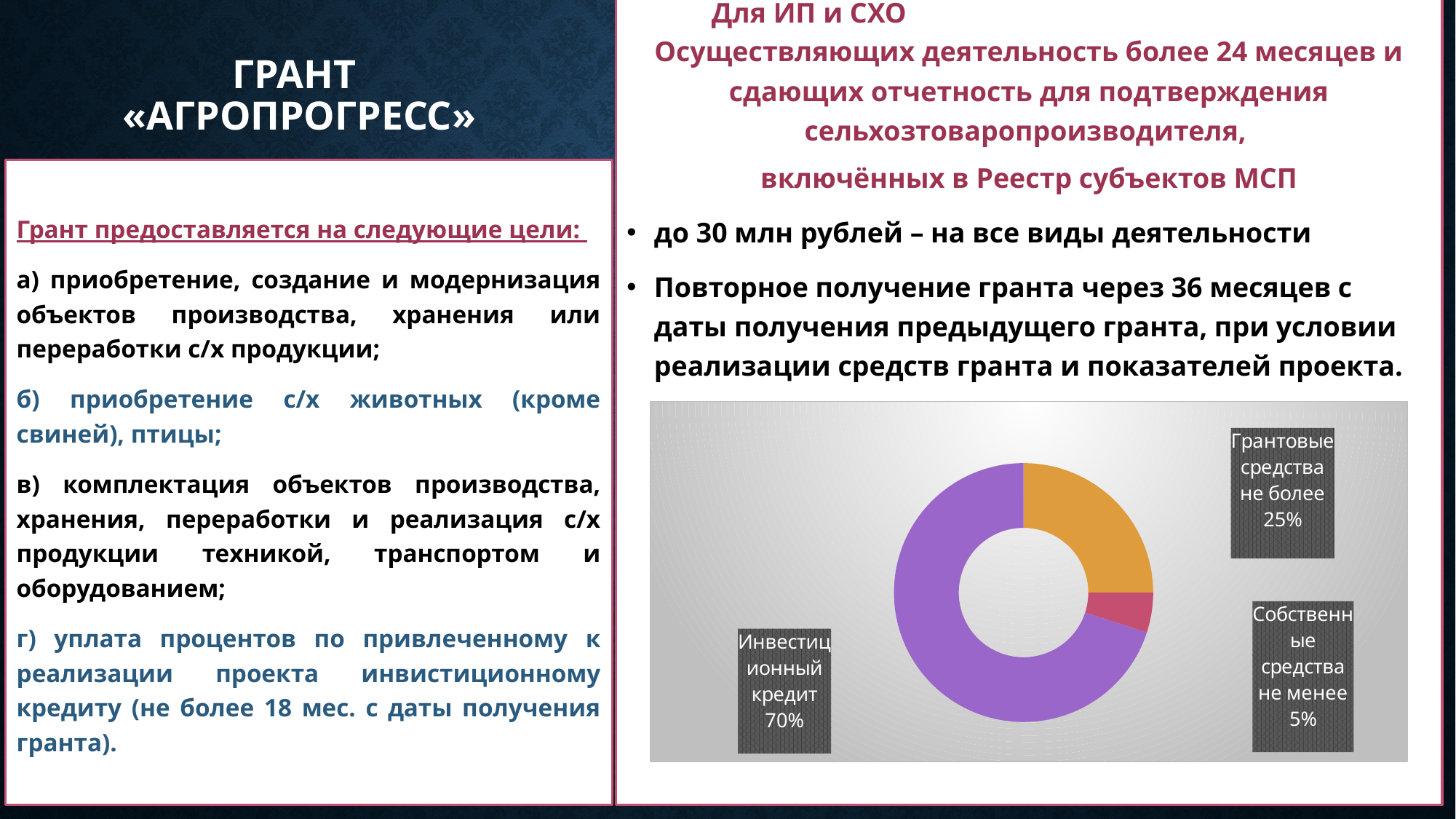
How many slices does the doughnut chart have? 3 What colour is the slice for "Грантовые средства"? Orange What percentage is shown for "Грантовые средства"? не более 25% What percentage is shown for "Собственные средства"? не менее 5% What share of the chart is labelled "Инвестиционный кредит"? 70% Which slice of the chart is the largest? Инвестиционный кредит Which slice of the chart is the smallest? Собственные средства What colour is the slice for "Инвестиционный кредит"? Purple What is the difference between the share for "Грантовые средства" and the share for "Собственные средства"? 20% What is the difference between the share for "Инвестиционный кредит" and the share for "Грантовые средства"? 45% What kind of chart is shown on the slide? Doughnut (pie) chart Which is larger: the share for "Грантовые средства" or the share for "Собственные средства"? Грантовые средства